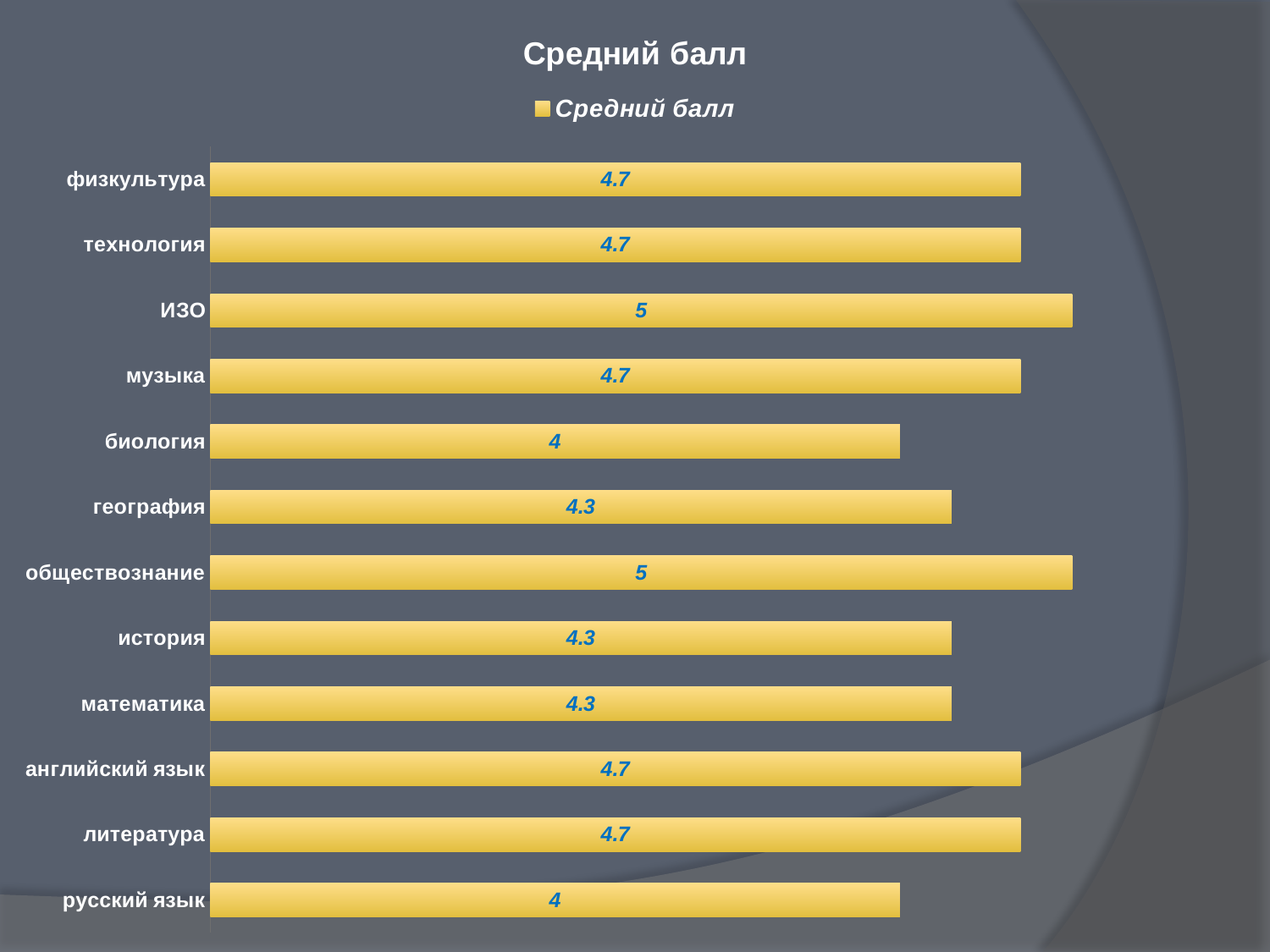
What is the average score (Средний балл) for ИЗО? 5 What is the value shown for английский язык? 4.7 How many categories are shown on the chart? 12 What is the value shown for биология? 4 How many series does the legend list? 1 What kind of chart is shown on the slide? bar chart What is the value shown for география? 4.3 What is the difference between the values for физкультура and математика? 0.4 What is the difference between the values for ИЗО and биология? 1 What is the value shown for русский язык? 4 Which has a larger value, обществознание or история? обществознание Which categories have the highest value on the chart? ИЗО and обществознание